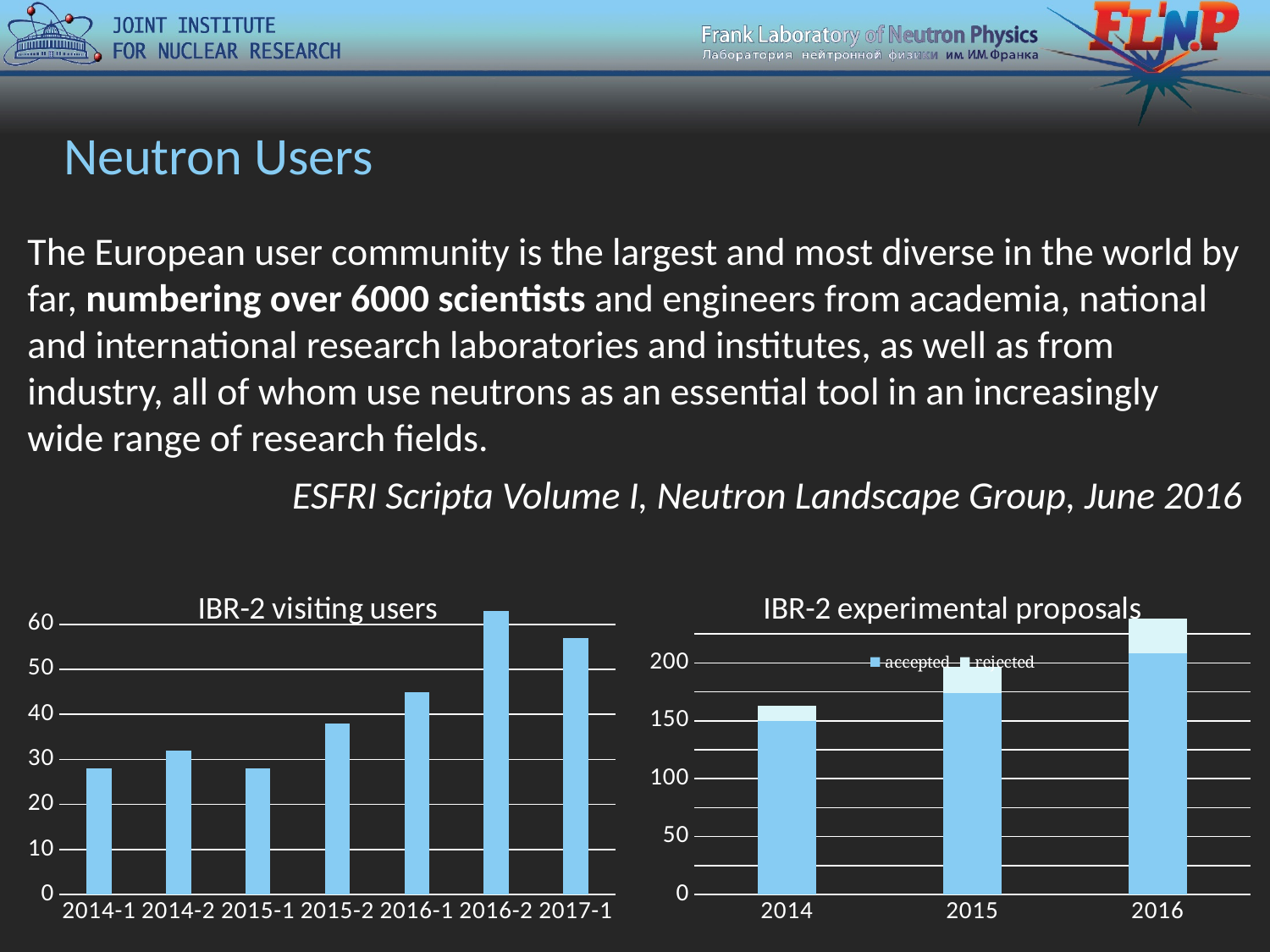
In the IBR-2 visiting users chart, how many periods are shown on the x axis? 7 In the IBR-2 experimental proposals chart, do the total proposals rise or fall from 2014 to 2016? rise In the IBR-2 visiting users chart, which period has the highest number of visiting users? 2016-2 In the IBR-2 visiting users chart, is the value for 2016-1 greater or less than 40? greater In the IBR-2 visiting users chart, what kind of chart is shown? bar chart In the IBR-2 visiting users chart, is the value for 2016-2 greater or less than 60? greater In the IBR-2 experimental proposals chart, how many years are shown on the x axis? 3 In the IBR-2 experimental proposals chart, what are the two series named in the legend? accepted, rejected In the IBR-2 visiting users chart, is the value for 2015-2 greater or less than 40? less In the IBR-2 experimental proposals chart, how many series does the legend list? 2 In the IBR-2 visiting users chart, which is larger, the value for 2014-2 or the value for 2015-2? 2015-2